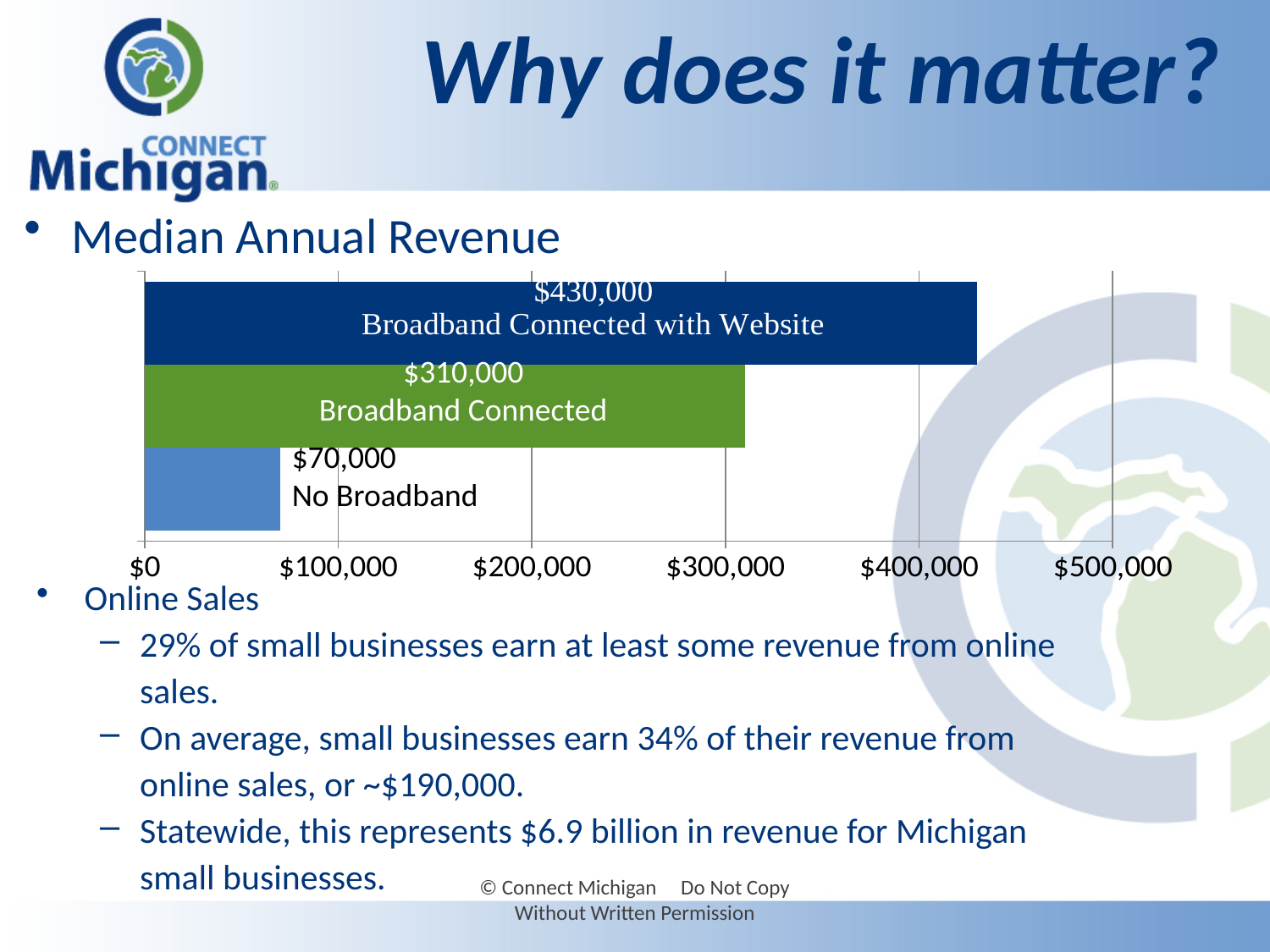
How many categories are shown in the Median Annual Revenue chart? 3 What is the median annual revenue for No Broadband? $70,000 What kind of chart is used to show Median Annual Revenue? Bar chart What is the median annual revenue for Broadband Connected? $310,000 What is the maximum value shown on the x axis of the Median Annual Revenue chart? $500,000 Is the median annual revenue for Broadband Connected with Website greater or less than $400,000? greater What is the difference in median annual revenue between Broadband Connected and No Broadband? $240,000 Which category has the highest median annual revenue? Broadband Connected with Website What is the median annual revenue for Broadband Connected with Website? $430,000 What is the difference in median annual revenue between Broadband Connected with Website and Broadband Connected? $120,000 Which category has the lowest median annual revenue? No Broadband Which has a higher median annual revenue, Broadband Connected or No Broadband? Broadband Connected